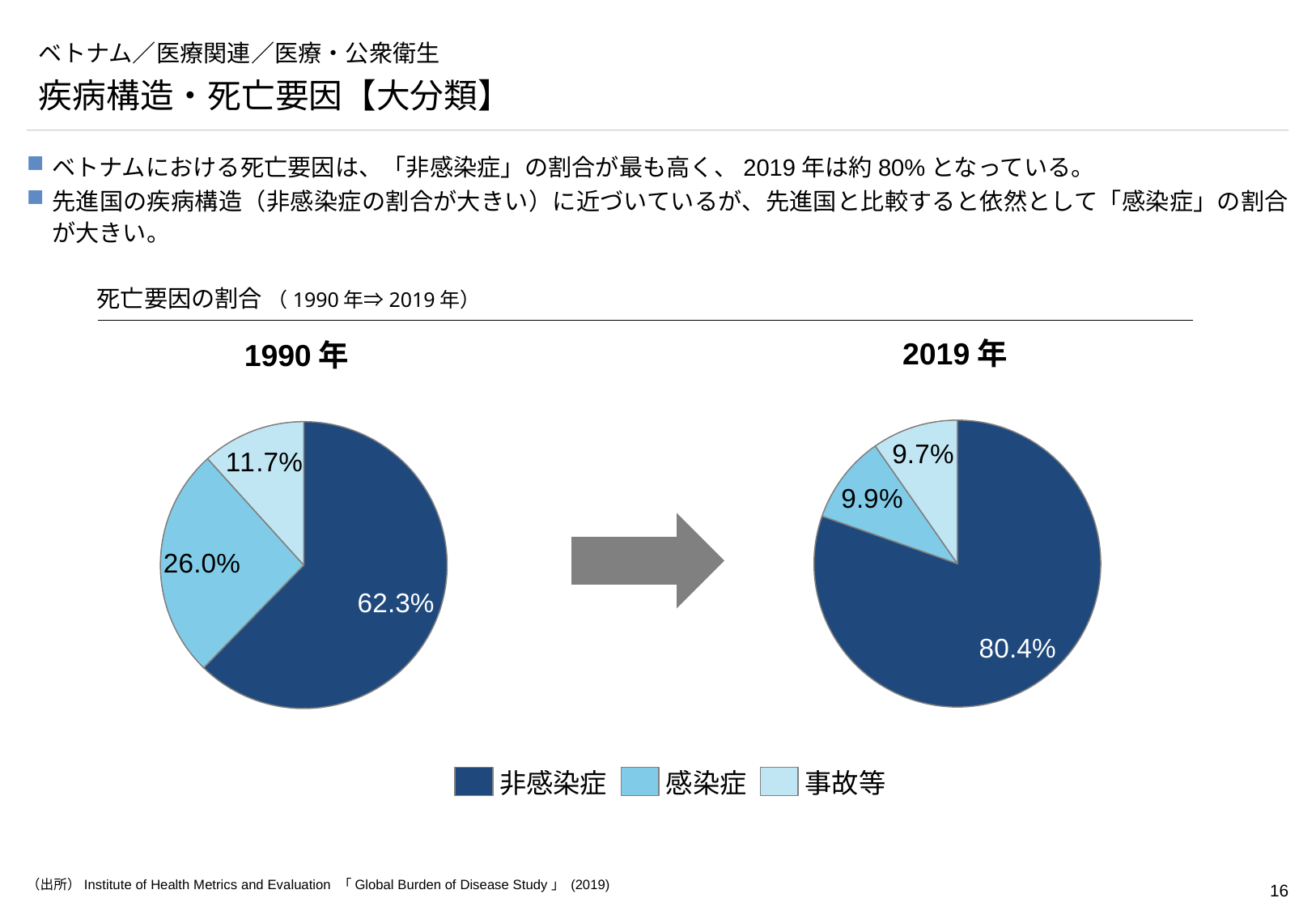
Which legend category is shown in the darkest blue? 非感染症 In the 1990年 pie chart, what share is shown for 事故等? 11.7% How many categories does the legend list? 3 In the 2019年 pie chart, which category has the smallest share? 事故等 What type of chart is used to show the 死亡要因の割合? Pie chart In the 2019年 pie chart, what share is shown for 非感染症? 80.4% In the 1990年 pie chart, what is the difference between the 感染症 share and the 事故等 share? 14.3% What is the difference between the 非感染症 share in 2019年 and in 1990年? 18.1% In the 1990年 pie chart, what share is shown for 非感染症? 62.3% Which is larger: the 感染症 share in 1990年 or the 感染症 share in 2019年? 1990年 In the 1990年 pie chart, which category has the largest share? 非感染症 In the 2019年 pie chart, what share is shown for 感染症? 9.9%